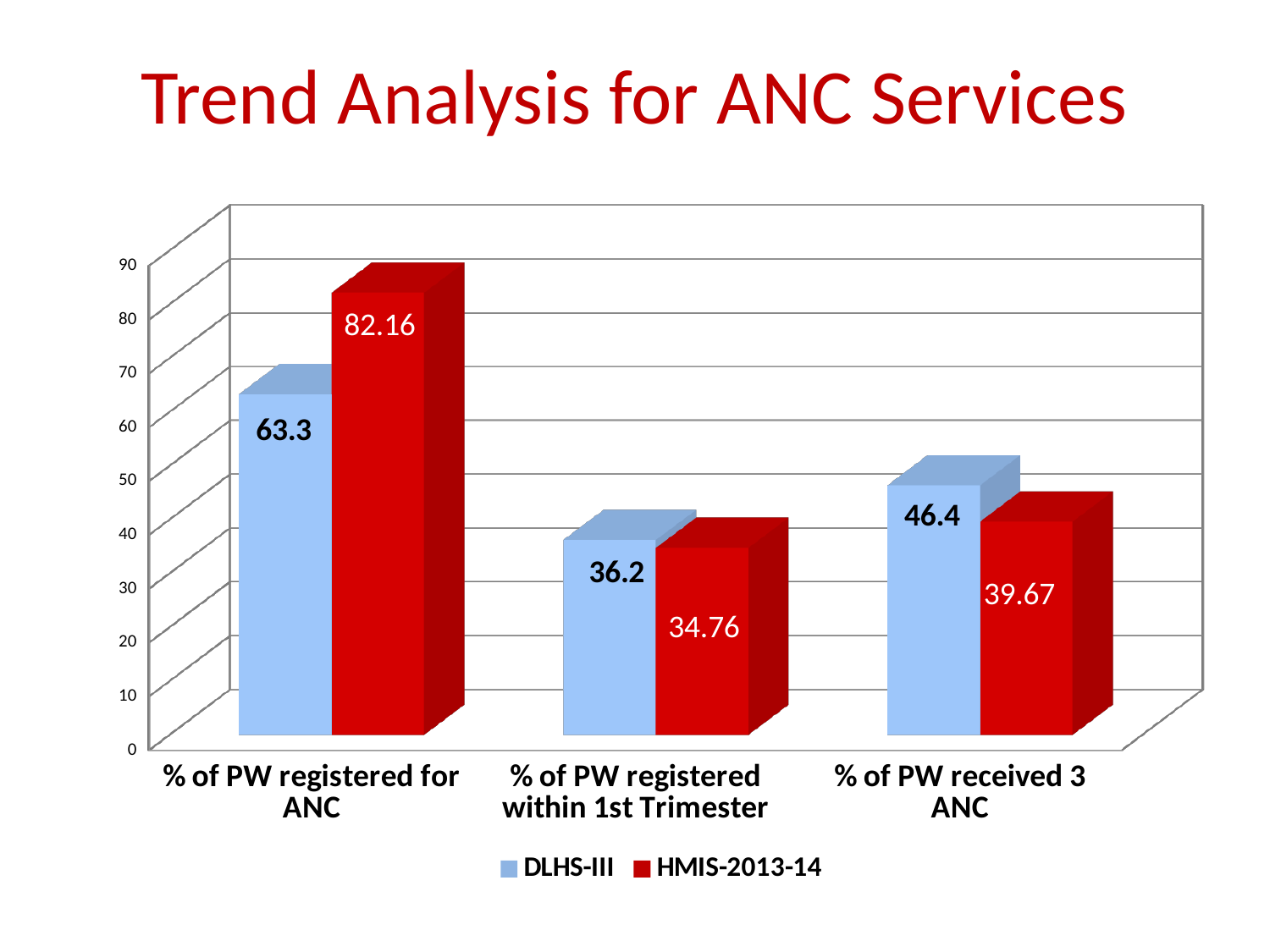
How many series does the legend list? 2 What is the HMIS-2013-14 value for % of PW registered for ANC? 82.16 What is the DLHS-III value for % of PW received 3 ANC? 46.4 What kind of chart is shown on the slide? Bar chart What is the DLHS-III value for % of PW registered for ANC? 63.3 How many categories are shown on the x axis? 3 Which category has the lowest DLHS-III value? % of PW registered within 1st Trimester What is the HMIS-2013-14 value for % of PW registered within 1st Trimester? 34.76 What is the title of the slide? Trend Analysis for ANC Services Which category has the highest HMIS-2013-14 value? % of PW registered for ANC What is the difference between the HMIS-2013-14 and DLHS-III values for % of PW registered for ANC? 18.86 For % of PW received 3 ANC, which series has the larger value, DLHS-III or HMIS-2013-14? DLHS-III